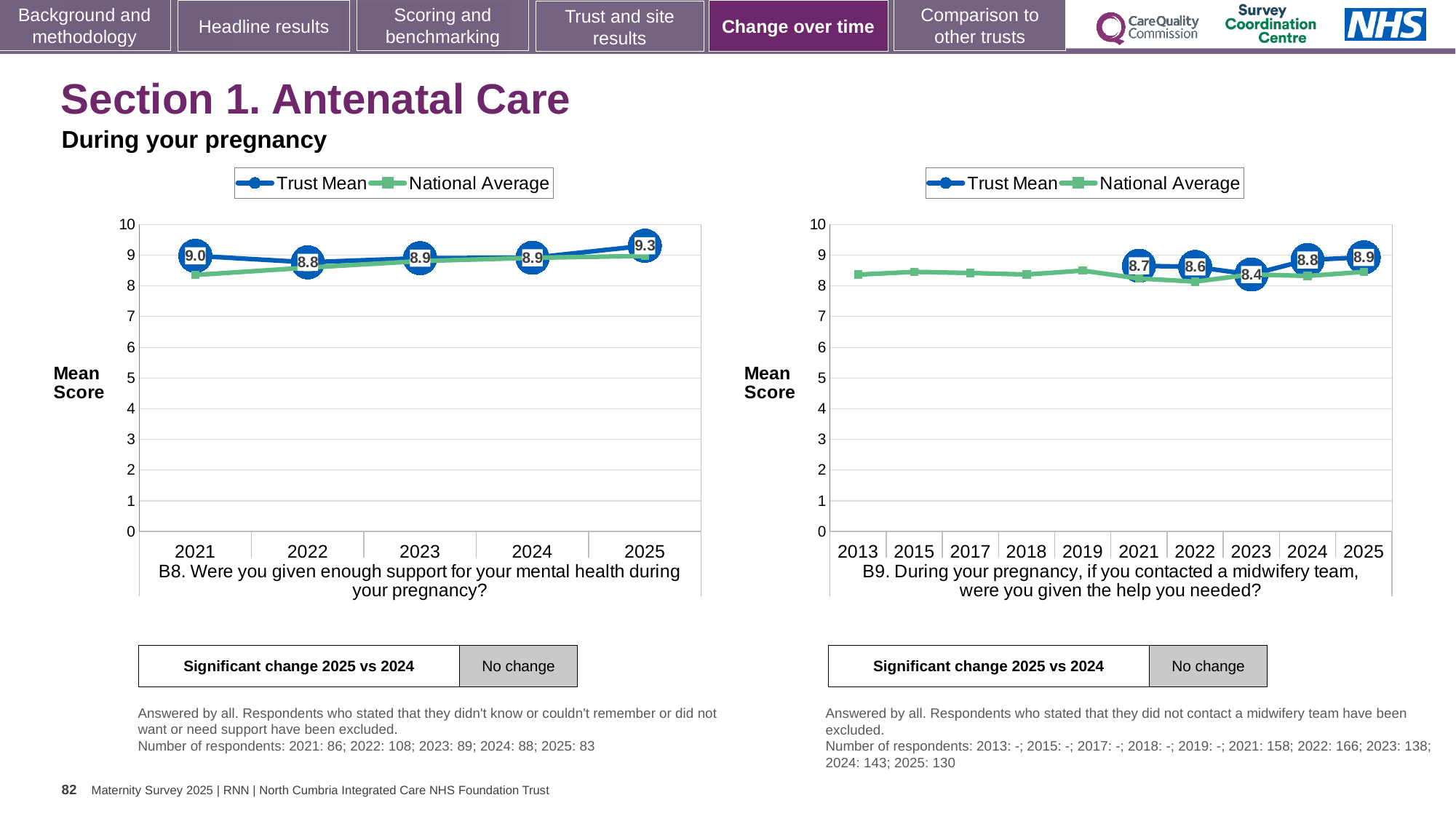
In the B8 chart (left), what is the difference between the Trust Mean in 2025 and in 2021? 0.3 In the B8 chart (left), what is the Trust Mean for 2022? 8.8 In the B8 chart (left), what is the Trust Mean for 2025? 9.3 In the B9 chart (right), what is the Trust Mean for 2023? 8.4 In the B8 chart (left), which year has the highest Trust Mean? 2025 In the B8 chart (left), how many years are shown on the x axis? 5 What kind of chart is the B9 chart (right)? Line chart In the B9 chart (right), is the Trust Mean for 2024 or 2022 larger? 2024 In the B9 chart (right), is the National Average for 2019 greater or less than 8? greater In the B9 chart (right), which year has the lowest labelled Trust Mean? 2023 In the B9 chart (right), what is the difference between the Trust Mean in 2025 and in 2023? 0.5 How many series does the legend of the B8 chart (left) list? 2